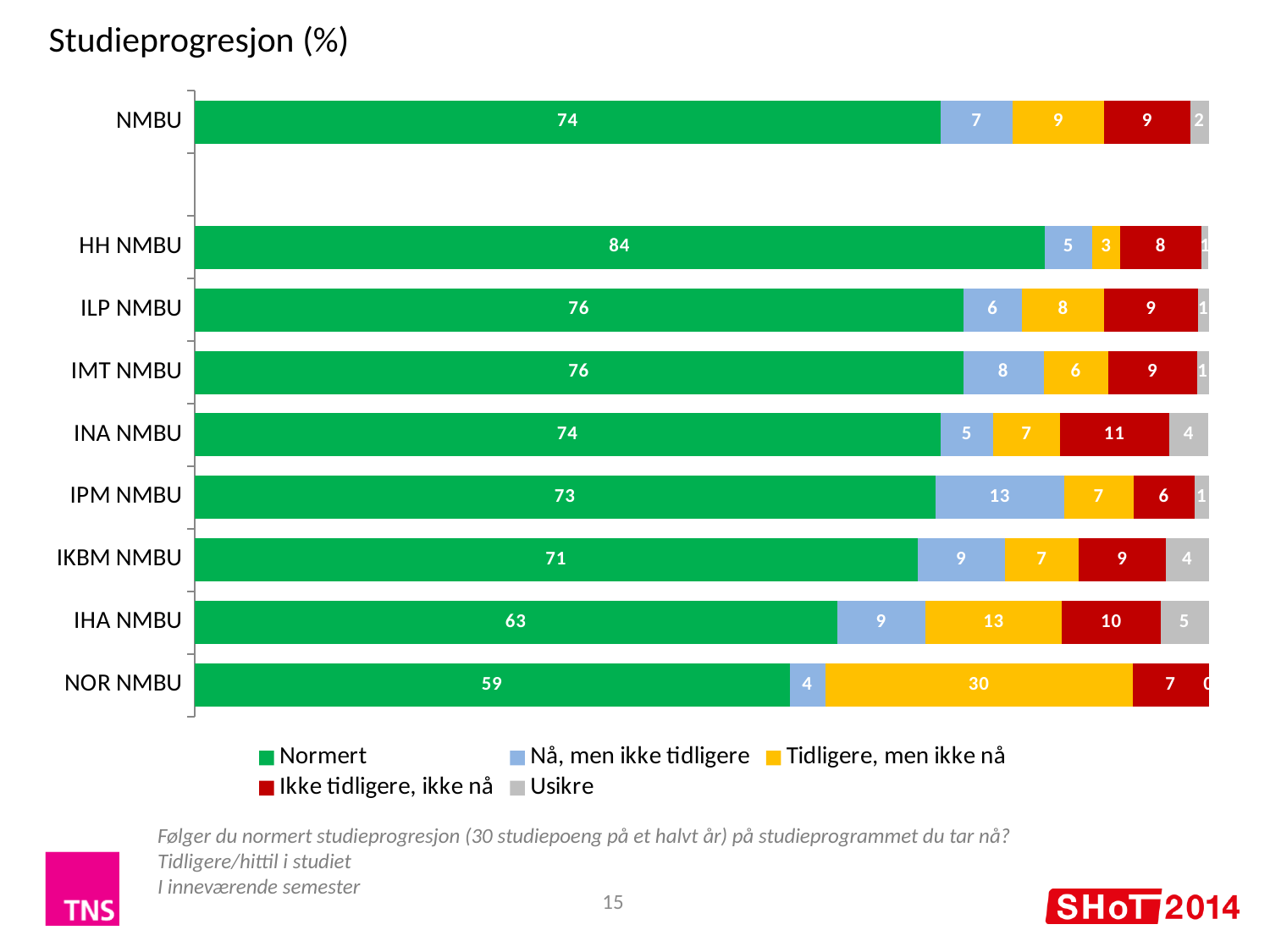
Which has a larger Normert value, IHA NMBU or IKBM NMBU? IKBM NMBU Which category has the lowest Normert value? NOR NMBU What kind of chart is shown on the slide? Stacked bar chart What is the 'Tidligere, men ikke nå' value for NOR NMBU? 30 Which category has the highest Normert value? HH NMBU How many categories are shown on the chart? 9 What is the 'Nå, men ikke tidligere' value for IPM NMBU? 13 What is the Normert value for HH NMBU? 84 What is the difference between the Normert values for HH NMBU and NOR NMBU? 25 What is the 'Ikke tidligere, ikke nå' value for INA NMBU? 11 How many series does the legend list? 5 What is the title of the chart? Studieprogresjon (%)